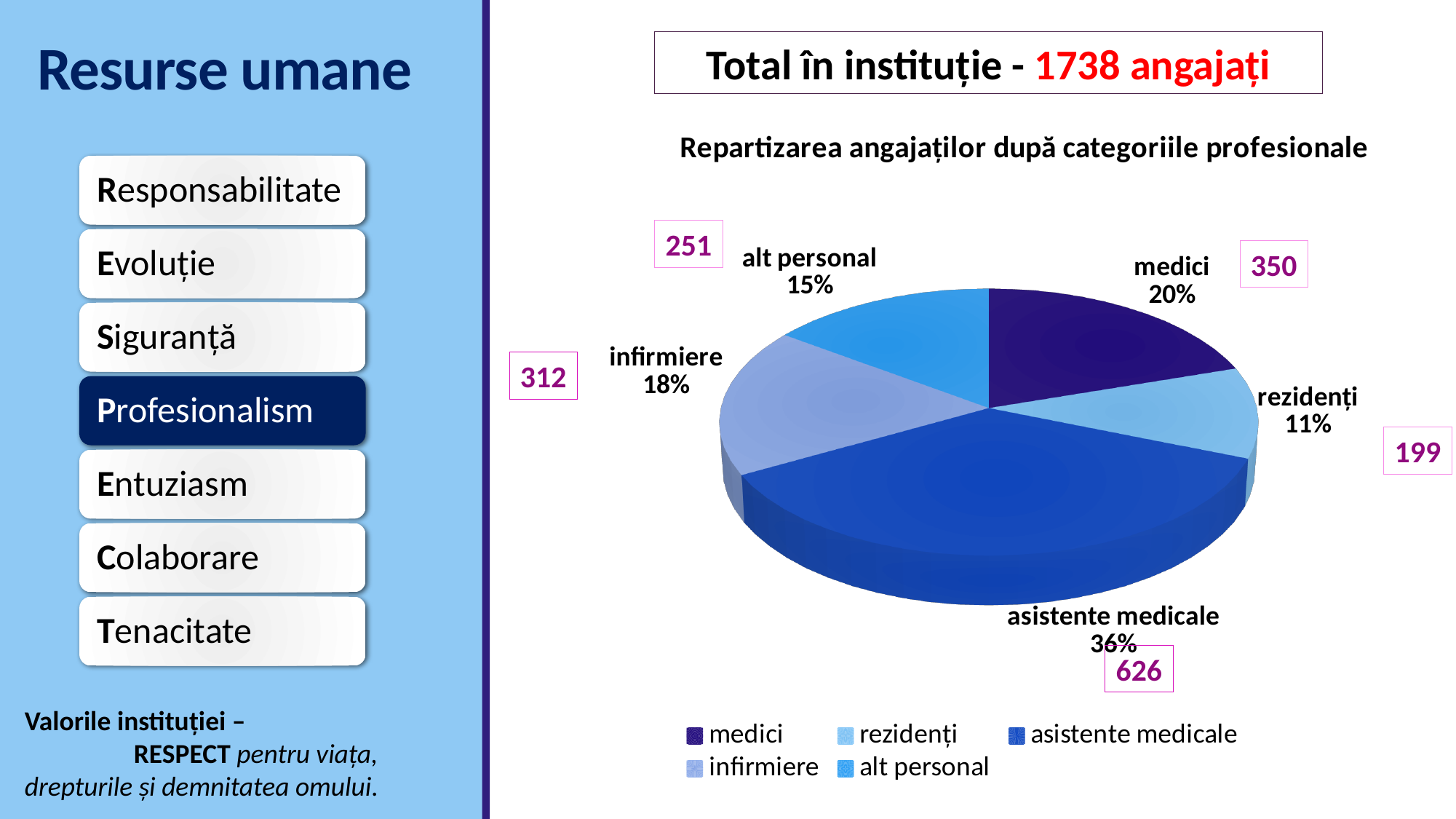
What is the difference in number of employees between asistente medicale and medici? 276 What percentage share of employees are rezidenți? 11% What percentage share of employees are medici? 20% Which category has more employees, infirmiere or alt personal? infirmiere What percentage share of employees are asistente medicale? 36% What is the title of the chart? Repartizarea angajaților după categoriile profesionale How many employees are in the alt personal category? 251 What kind of chart is shown on the slide? pie chart Which category has the smallest share of employees? rezidenți How many employees are in the infirmiere category? 312 How many categories does the pie chart have? 5 Which category has the largest share of employees? asistente medicale